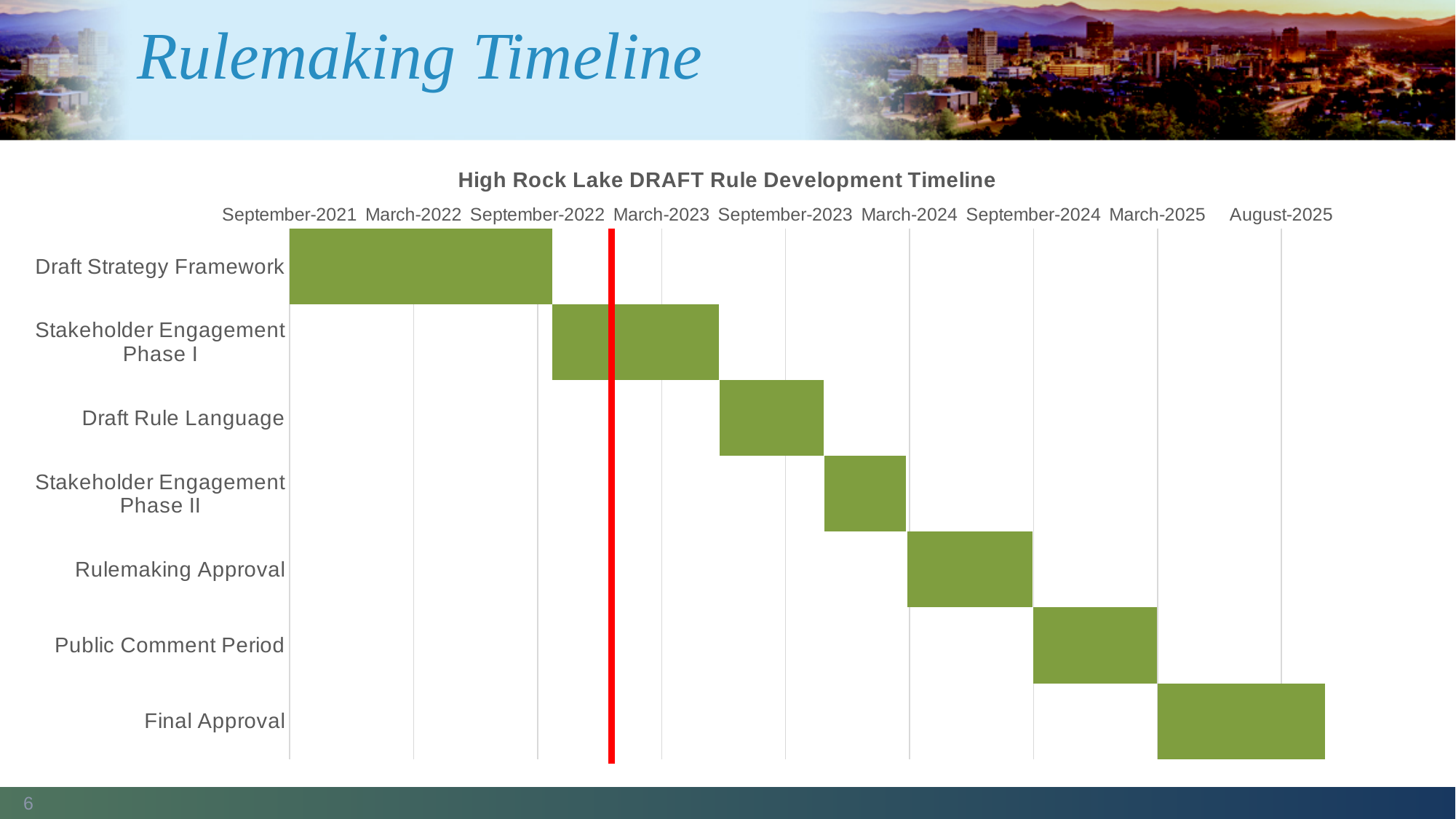
Do the task bars move later in time as you go down the list of tasks? Yes, each successive task starts later Which task is the first one listed at the top of the chart? Draft Strategy Framework Which task has the longest bar in the chart? Draft Strategy Framework Which task's bar begins at September-2021? Draft Strategy Framework Which task's bar extends to August-2025? Final Approval Which task's bar does the red vertical line pass through? Stakeholder Engagement Phase I Which task has the shortest bar in the chart? Stakeholder Engagement Phase II Which task comes immediately after Draft Rule Language in the timeline? Stakeholder Engagement Phase II How many tasks are listed on the vertical axis of the chart? 7 What is the title of the chart? High Rock Lake DRAFT Rule Development Timeline What kind of chart is shown on the slide? Bar chart (Gantt timeline) Is the bar for Draft Strategy Framework longer or shorter than the bar for Public Comment Period? longer